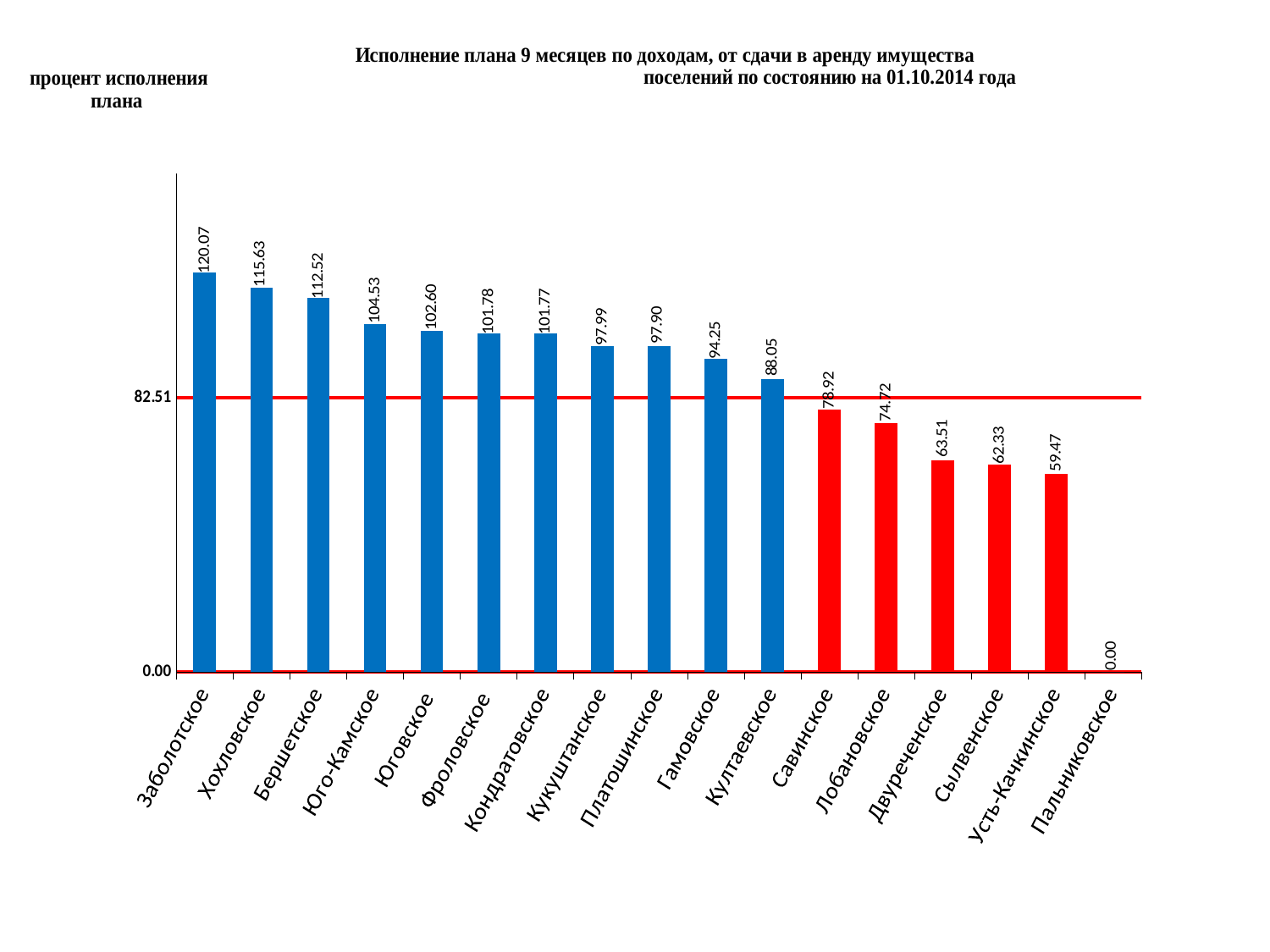
What is the value for Савинское? 78.92 Do the values rise or fall from left to right along the x axis? Fall Which category has the lowest value? Пальниковское Which category has the highest value? Заболотское What colour are the bars for categories with values below the red line? Red How many categories are shown on the x axis? 17 What is the difference between the values for Заболотское and Хохловское? 4.44 What is the value for Заболотское? 120.07 Which is larger, the value for Савинское or the value for Лобановское? Савинское What value is marked by the horizontal red line? 82.51 What is the value for Усть-Качкинское? 59.47 What kind of chart is this? Bar chart